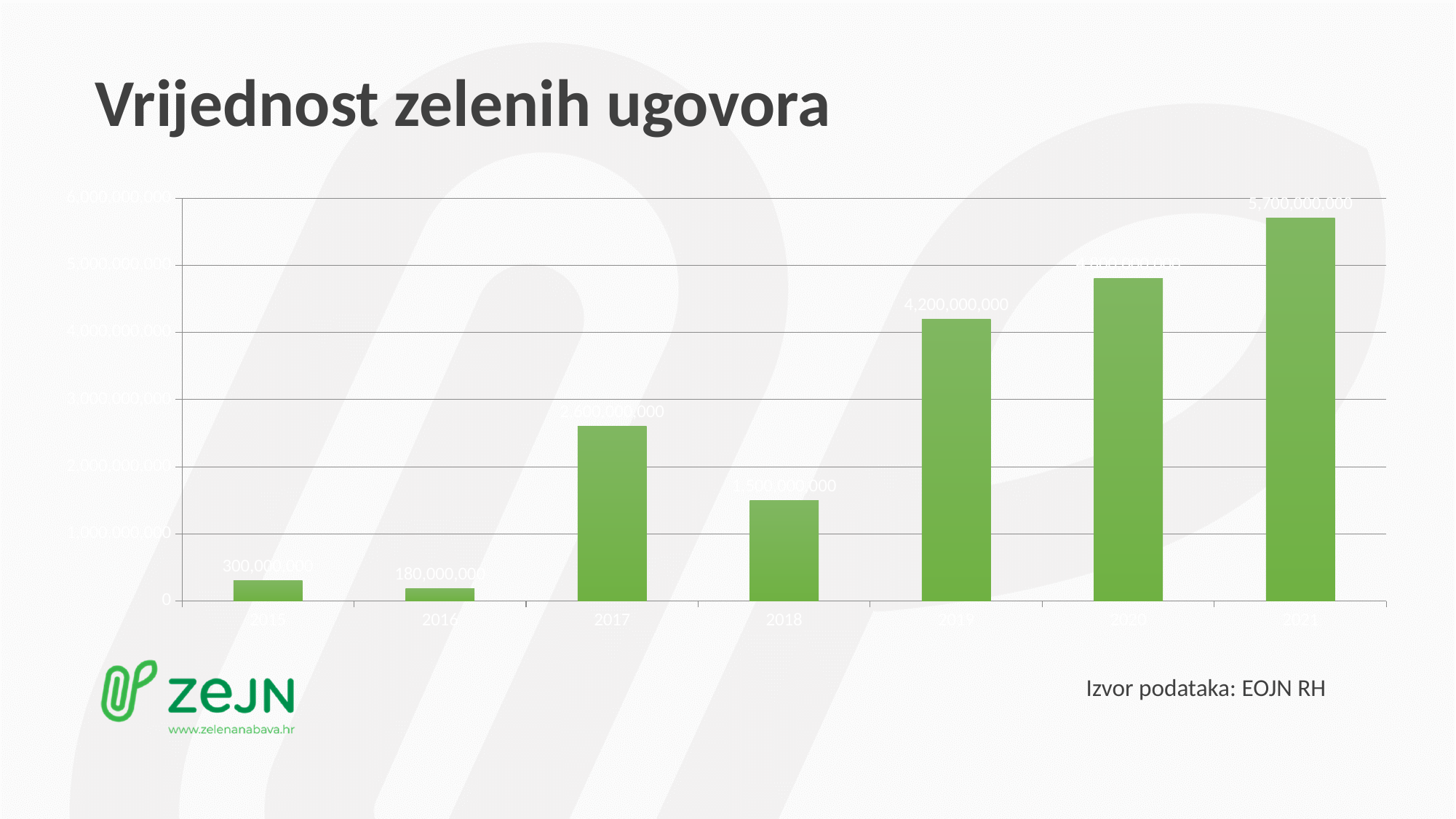
Which year has the lowest value? 2016 What is the value for 2016? 180,000,000 What is the value for 2019? 4,200,000,000 Is the value for 2020 greater or less than 4,000,000,000? greater How many years are shown on the x axis of the chart? 7 Which year has the highest value? 2021 What is the value for 2015? 300,000,000 What is the difference between the values for 2015 and 2016? 120,000,000 Which year has the larger value, 2017 or 2018? 2017 What is the title of the chart? Vrijednost zelenih ugovora What kind of chart is shown on the slide? bar chart What is the value for 2018? 1,500,000,000